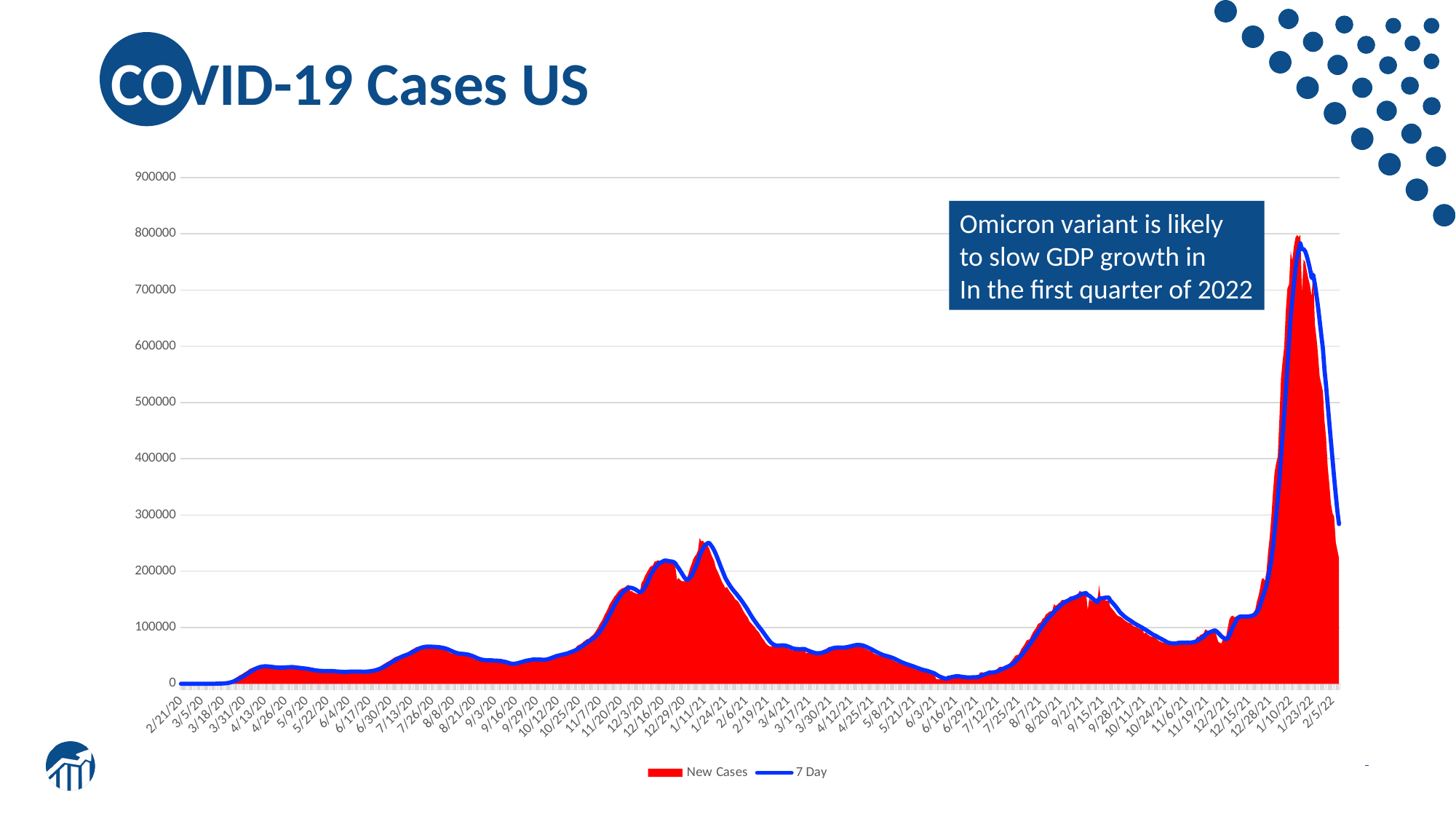
What is the title of the chart on the slide? COVID-19 Cases US Is the peak value of New Cases around 1/10/22 greater or less than 700000? greater What are the two series named in the legend? New Cases and 7 Day What kind of chart is shown on the slide? Area chart with a line overlay How many series does the chart's legend list? 2 Is the value of the 7 Day series around 6/16/21 greater or less than 100000? less Is the value of the 7 Day series at the last date, 2/5/22, greater or less than 400000? less Which peak is higher: the one around 1/11/21 or the one around 1/10/22? 1/10/22 Do the values rise or fall between 6/16/21 and 9/2/21? rise Do the values rise or fall between 1/23/22 and 2/5/22? fall